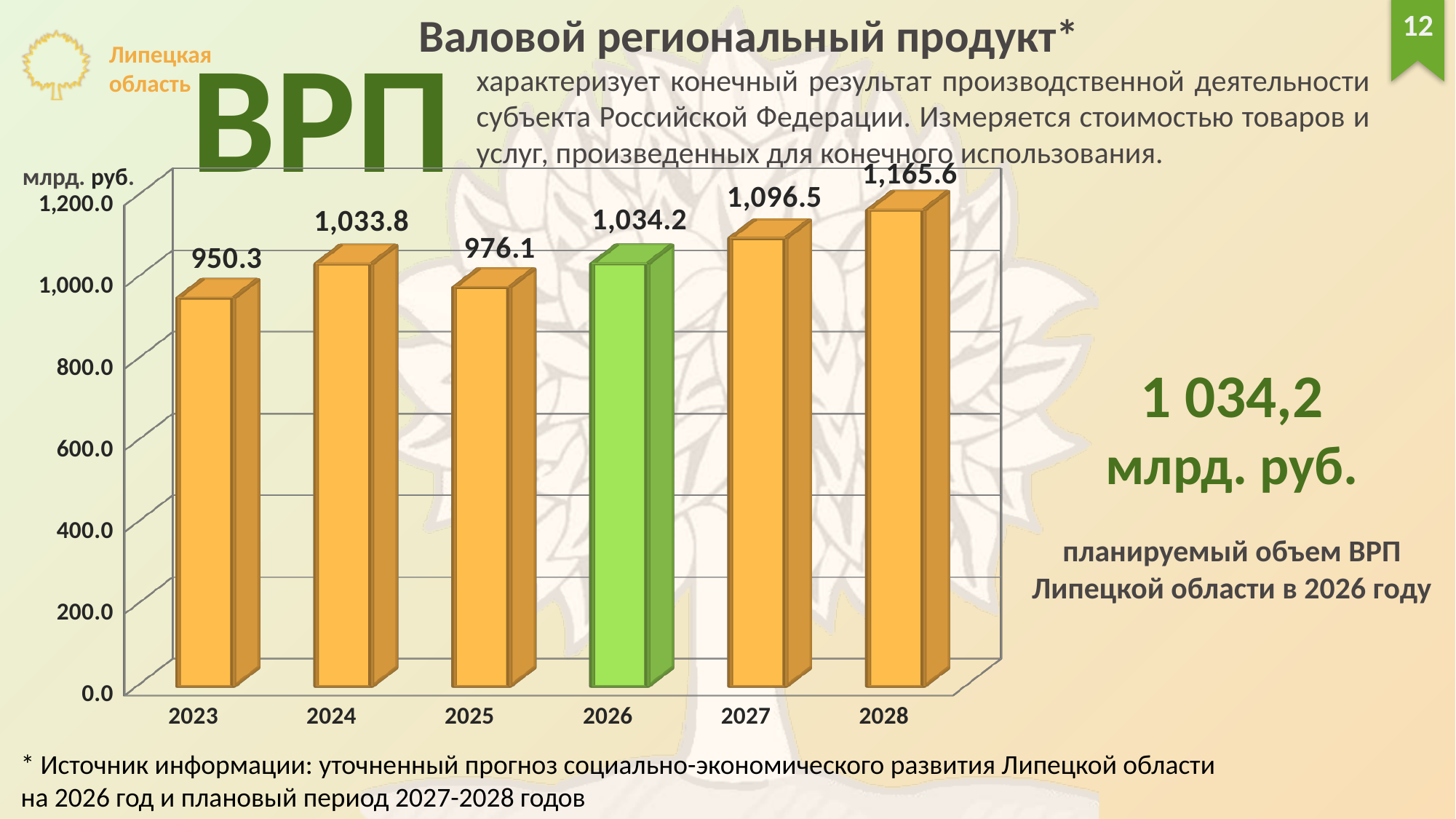
What kind of chart is shown on the slide? bar chart What is the difference between the values for 2028 and 2027? 69.1 Which year has the highest value? 2028 What is the difference between the values for 2024 and 2023? 83.5 Which is larger, the value for 2025 or the value for 2027? 2027 Which year has the lowest value? 2023 What is the value for 2023? 950.3 What is the value for 2026? 1,034.2 Which year's bar is coloured green instead of orange? 2026 How many years are shown on the x axis? 6 What is the value for 2028? 1,165.6 Is the value for 2023 greater or less than 1,000.0? less